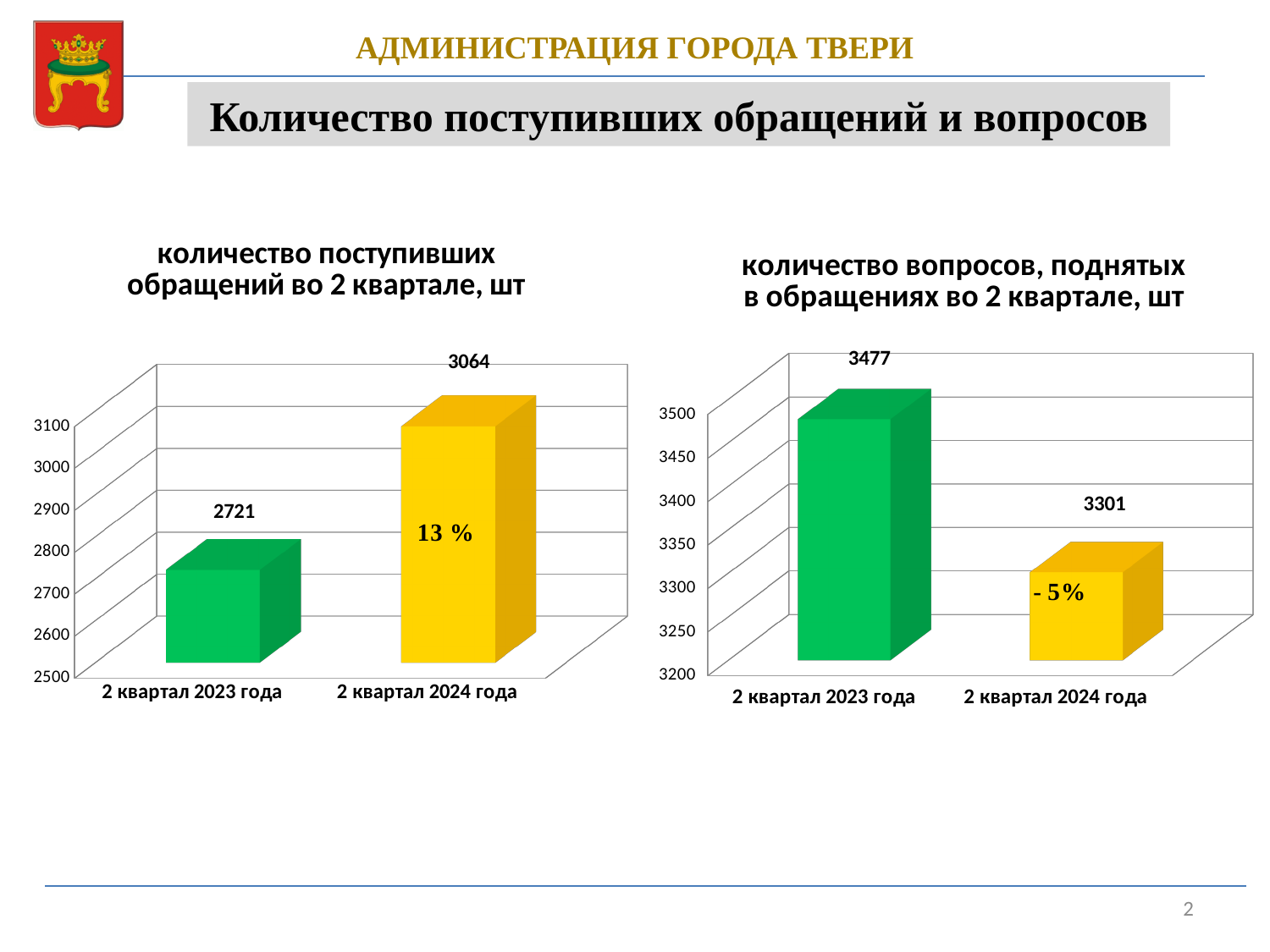
In the left chart (количество поступивших обращений во 2 квартале, шт), what is the value for 2 квартал 2023 года? 2721 In the right chart, which category has the lower value? 2 квартал 2024 года What kind of chart is the right chart? bar chart In the right chart (количество вопросов, поднятых в обращениях во 2 квартале, шт), what is the value for 2 квартал 2023 года? 3477 In the right chart, do the values rise or fall from 2 квартал 2023 года to 2 квартал 2024 года? fall In the right chart, what is the difference between the values for 2 квартал 2023 года and 2 квартал 2024 года? 176 What percentage change is printed on the 2 квартал 2024 года bar in the left chart? 13 % In the right chart (количество вопросов, поднятых в обращениях во 2 квартале, шт), what is the value for 2 квартал 2024 года? 3301 In the left chart, which category has the higher value? 2 квартал 2024 года How many categories does the left chart show? 2 In the left chart, what is the difference between the values for 2 квартал 2024 года and 2 квартал 2023 года? 343 In the left chart (количество поступивших обращений во 2 квартале, шт), what is the value for 2 квартал 2024 года? 3064